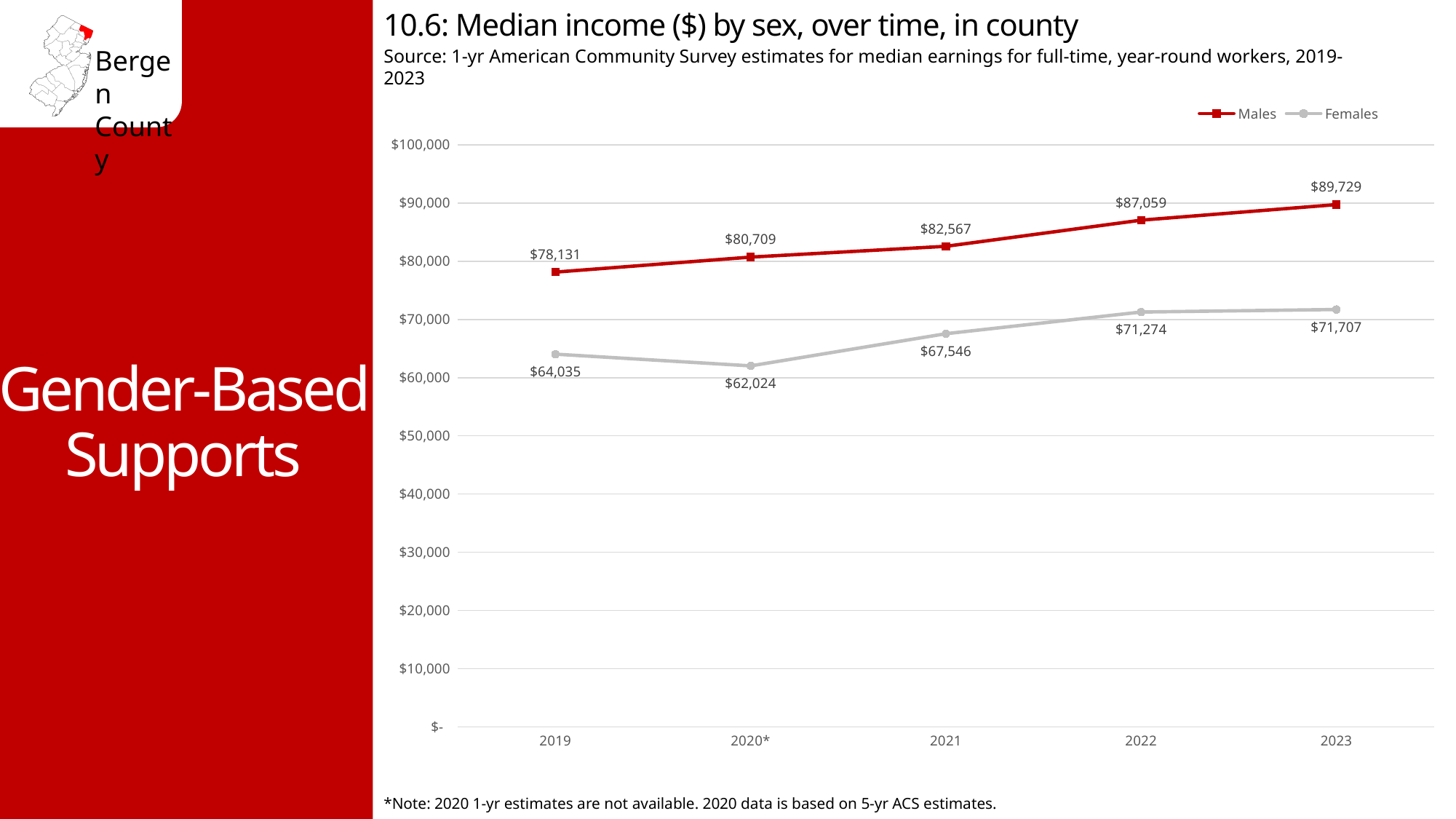
What kind of chart is shown on the slide? line chart What is the difference between the Males median income in 2023 and in 2022? $2,670 In which year is the median income for Males highest? 2023 What is the difference between the Males and Females median income in 2019? $14,096 What is the median income for Females in 2020*? $62,024 What is the median income for Females in 2021? $67,546 How many years are shown on the x axis? 5 In which year is the median income for Females lowest? 2020* Is the Males median income in 2021 greater or less than $80,000? greater How many series does the legend list? 2 Which is larger, the Females median income in 2022 or in 2021? 2022 What is the median income for Males in 2023? $89,729